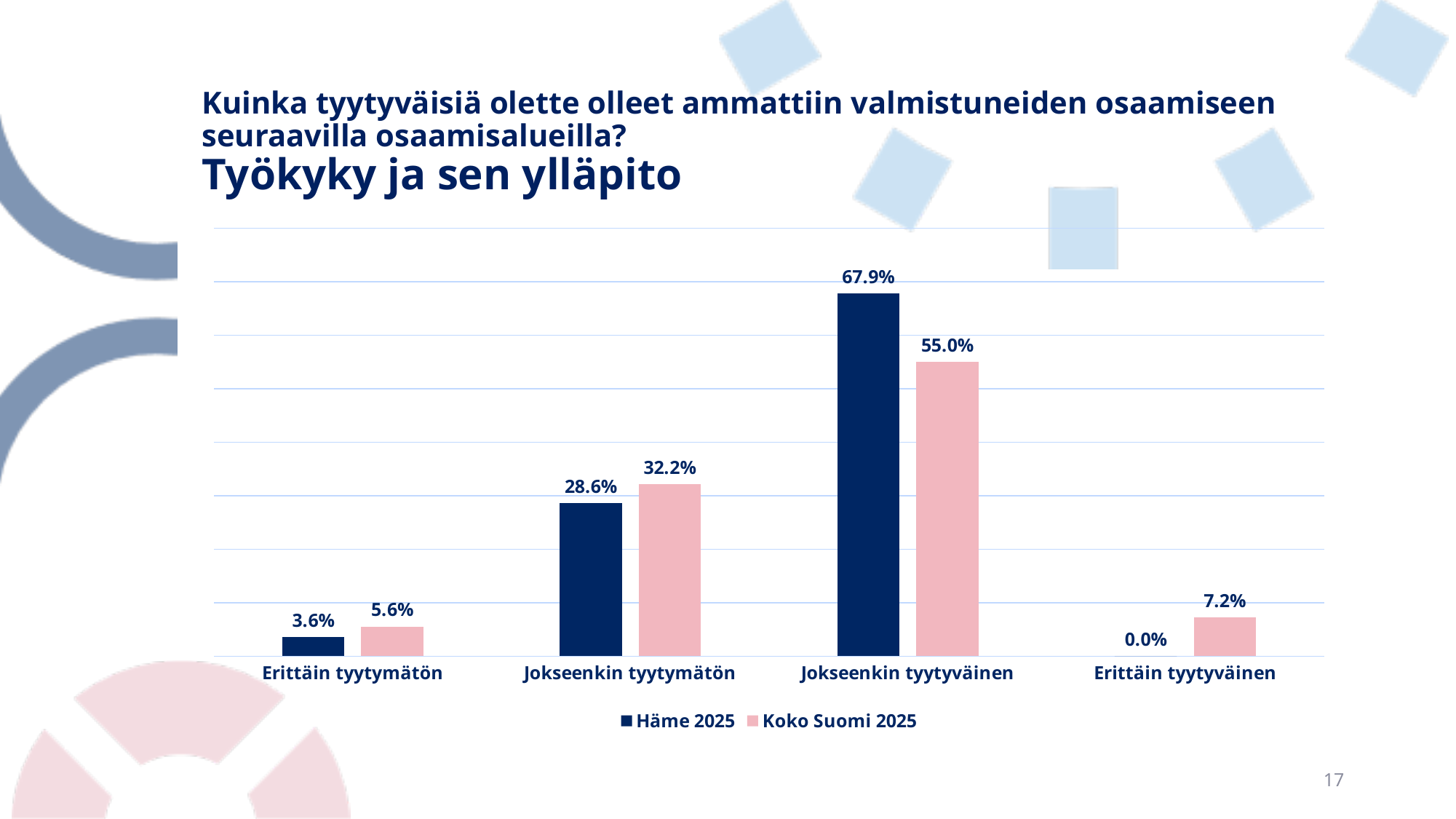
What colour are the bars for the Koko Suomi 2025 series? Pink What is the value for Koko Suomi 2025 in the Erittäin tyytymätön category? 5.6% How many series does the legend list? 2 Which category has the highest value for Häme 2025? Jokseenkin tyytyväinen How many categories are shown on the x axis? 4 What is the value for Häme 2025 in the Erittäin tyytyväinen category? 0.0% What kind of chart is shown on the slide? Bar chart What is the difference between Häme 2025 and Koko Suomi 2025 in the Jokseenkin tyytyväinen category? 12.9% In the Jokseenkin tyytymätön category, which series has the larger value, Häme 2025 or Koko Suomi 2025? Koko Suomi 2025 What is the value for Koko Suomi 2025 in the Jokseenkin tyytymätön category? 32.2% Which category has the lowest value for Koko Suomi 2025? Erittäin tyytymätön What is the value for Häme 2025 in the Jokseenkin tyytyväinen category? 67.9%